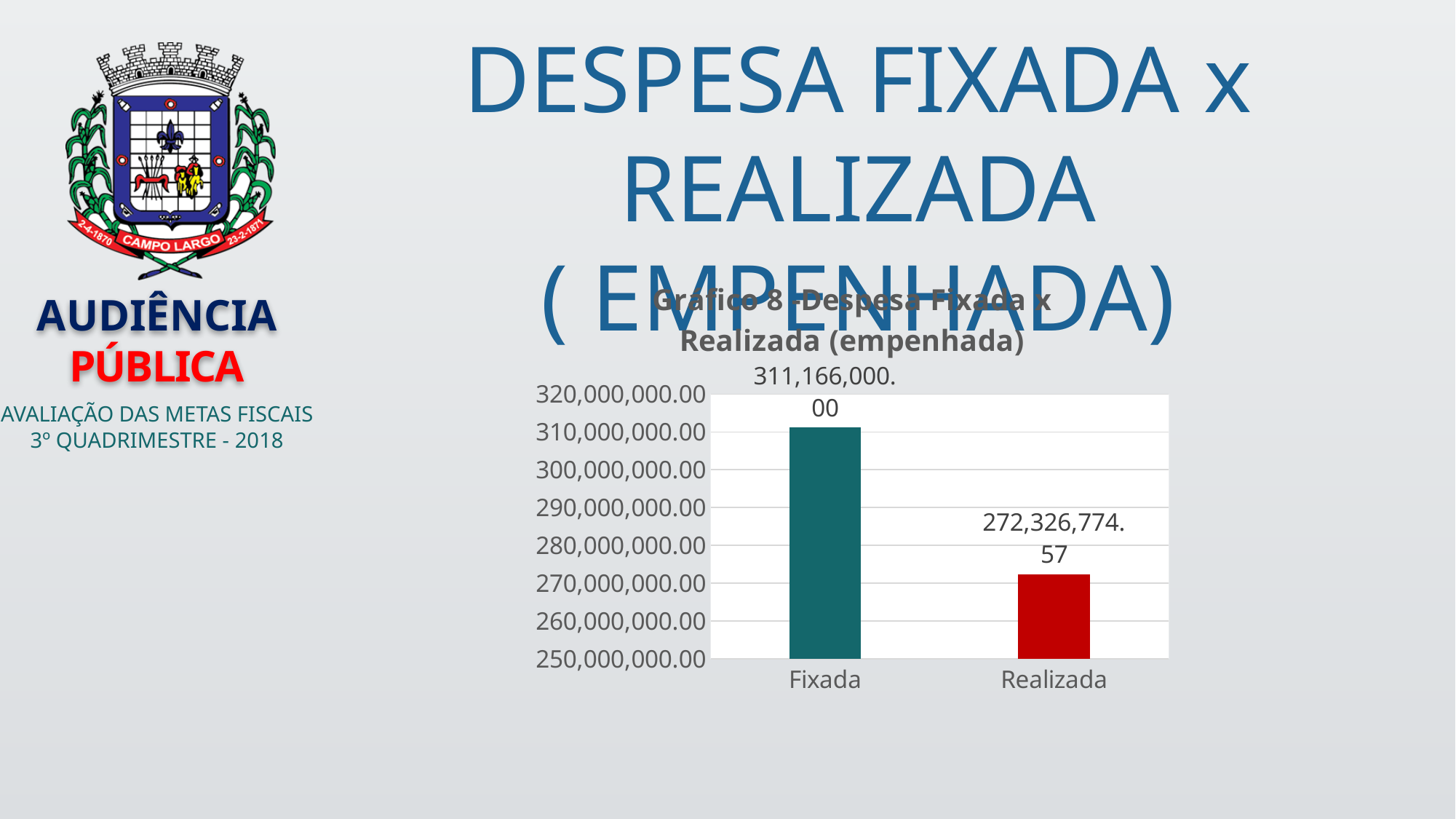
How many categories are shown on the x axis? 2 What is the value of the Fixada bar? 311,166,000.00 Is the value for Fixada greater or less than 300,000,000.00? greater Which category has the highest value? Fixada What colour is the Realizada bar? red Which category has the lowest value? Realizada What is the value of the Realizada bar? 272,326,774.57 What is the difference between the Fixada and Realizada values? 38,839,225.43 What is the title of the chart? Gráfico 8 - Despesa Fixada x Realizada (empenhada) What kind of chart is shown on the slide? bar chart Is the value for Realizada greater or less than 280,000,000.00? less Which is larger, Fixada or Realizada? Fixada